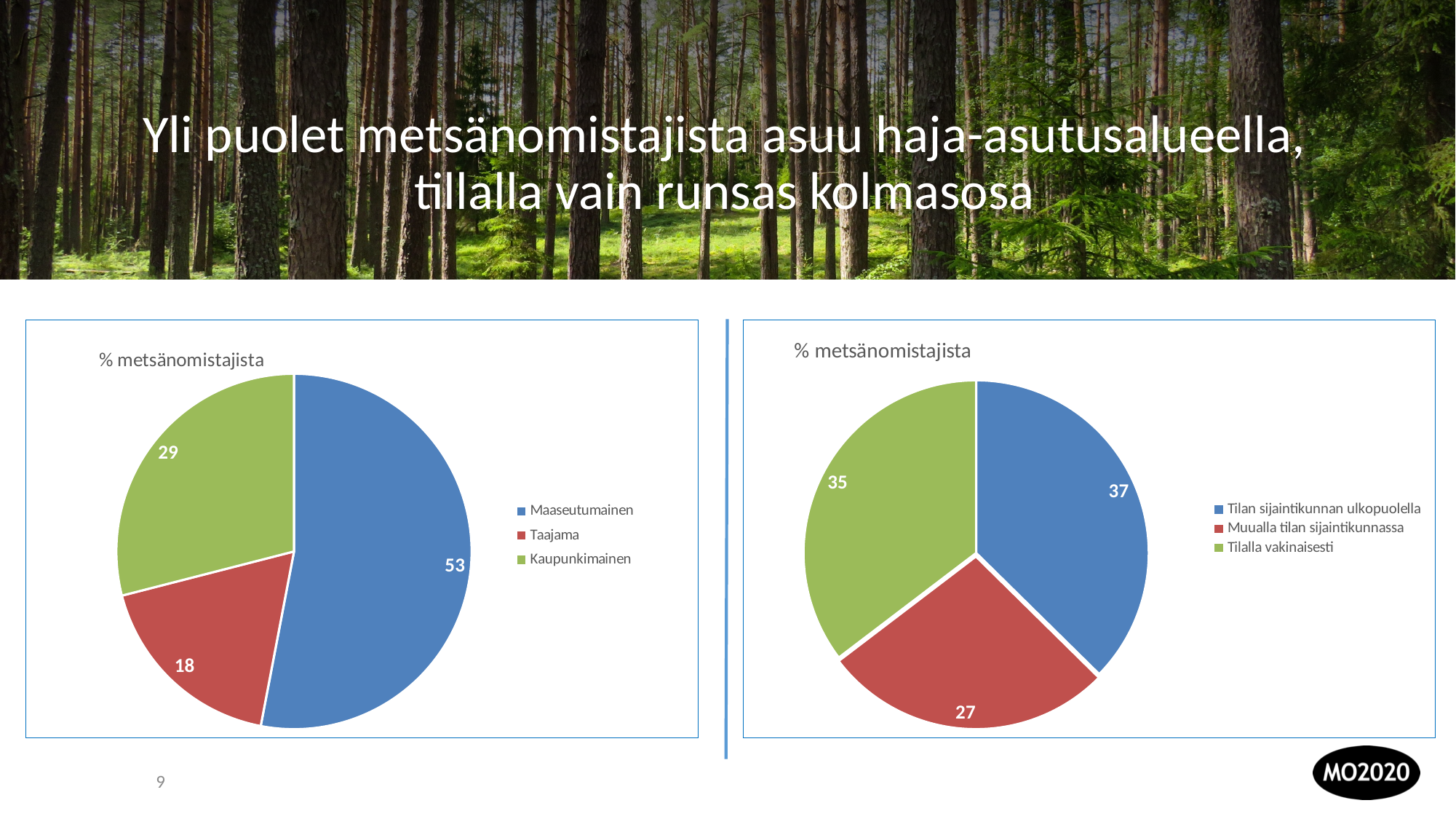
In the left pie chart, which is larger: Kaupunkimainen or Taajama? Kaupunkimainen What type of chart is shown on the left side of the slide? Pie chart In the left pie chart, what is the value for Taajama? 18 In the left pie chart, which category has the largest slice? Maaseutumainen In the right pie chart, what colour is the slice for Tilalla vakinaisesti? Green In the right pie chart, what is the value for Muualla tilan sijaintikunnassa? 27 In the right pie chart, what is the difference between the values for Tilan sijaintikunnan ulkopuolella and Muualla tilan sijaintikunnassa? 10 In the left pie chart, what is the difference between the values for Kaupunkimainen and Taajama? 11 In the right pie chart, what is the value for Tilalla vakinaisesti? 35 In the left pie chart, what is the value for Maaseutumainen? 53 In the right pie chart, which category has the smallest slice? Muualla tilan sijaintikunnassa How many slices does the right pie chart have? 3